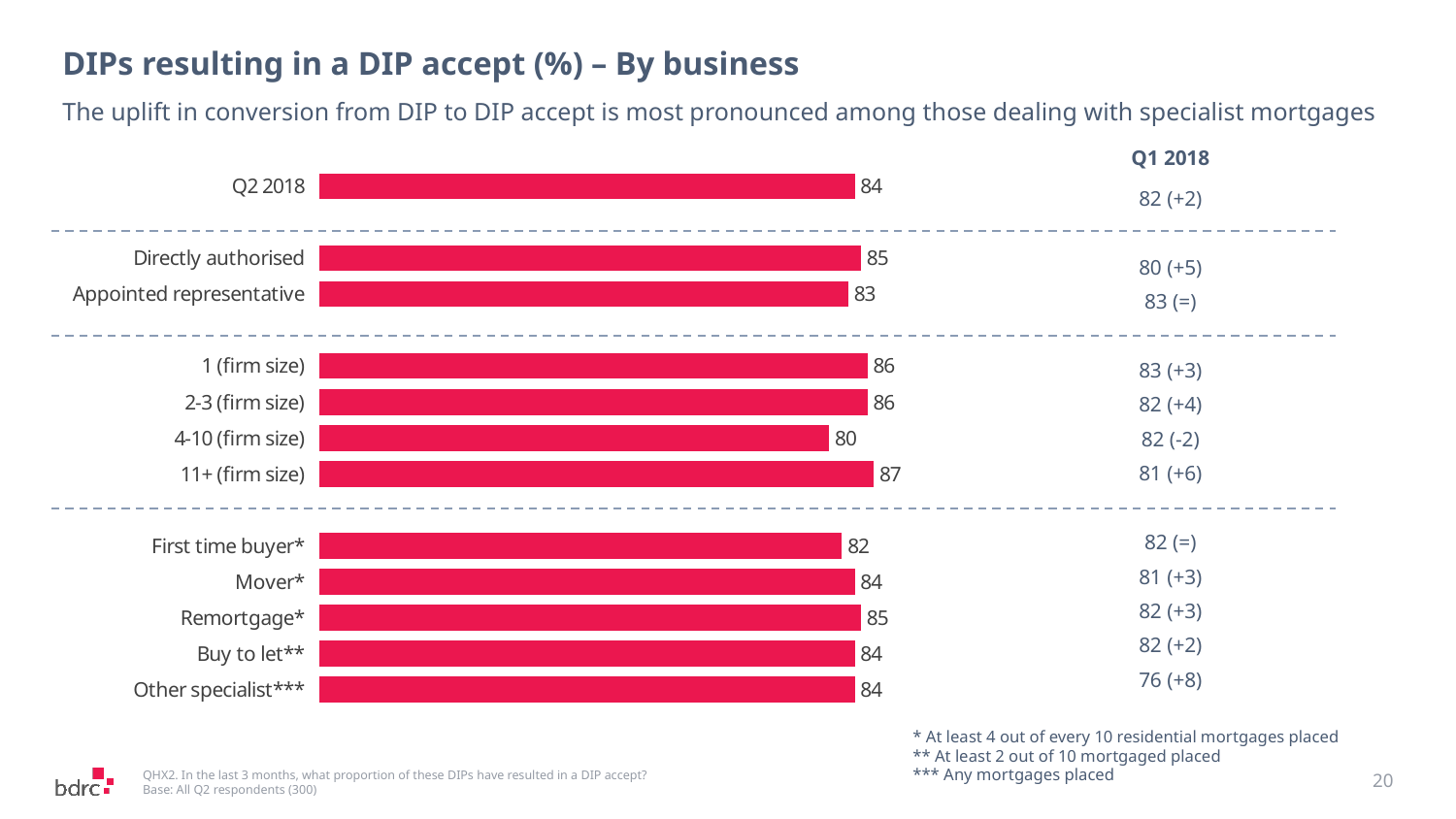
How many bars are plotted in the chart? 12 Which category has the highest value? 11+ (firm size) What is the value for First time buyer*? 82 What is the value for Directly authorised? 85 Which is larger, the value for Remortgage* or the value for First time buyer*? Remortgage* What is the difference between the values for 11+ (firm size) and 4-10 (firm size)? 7 What is the title of the chart? DIPs resulting in a DIP accept (%) – By business What type of chart is shown on the slide? bar chart What is the value for Other specialist***? 84 What is the value for 4-10 (firm size)? 80 What is the difference between the values for Directly authorised and Appointed representative? 2 Which category has the lowest value? 4-10 (firm size)